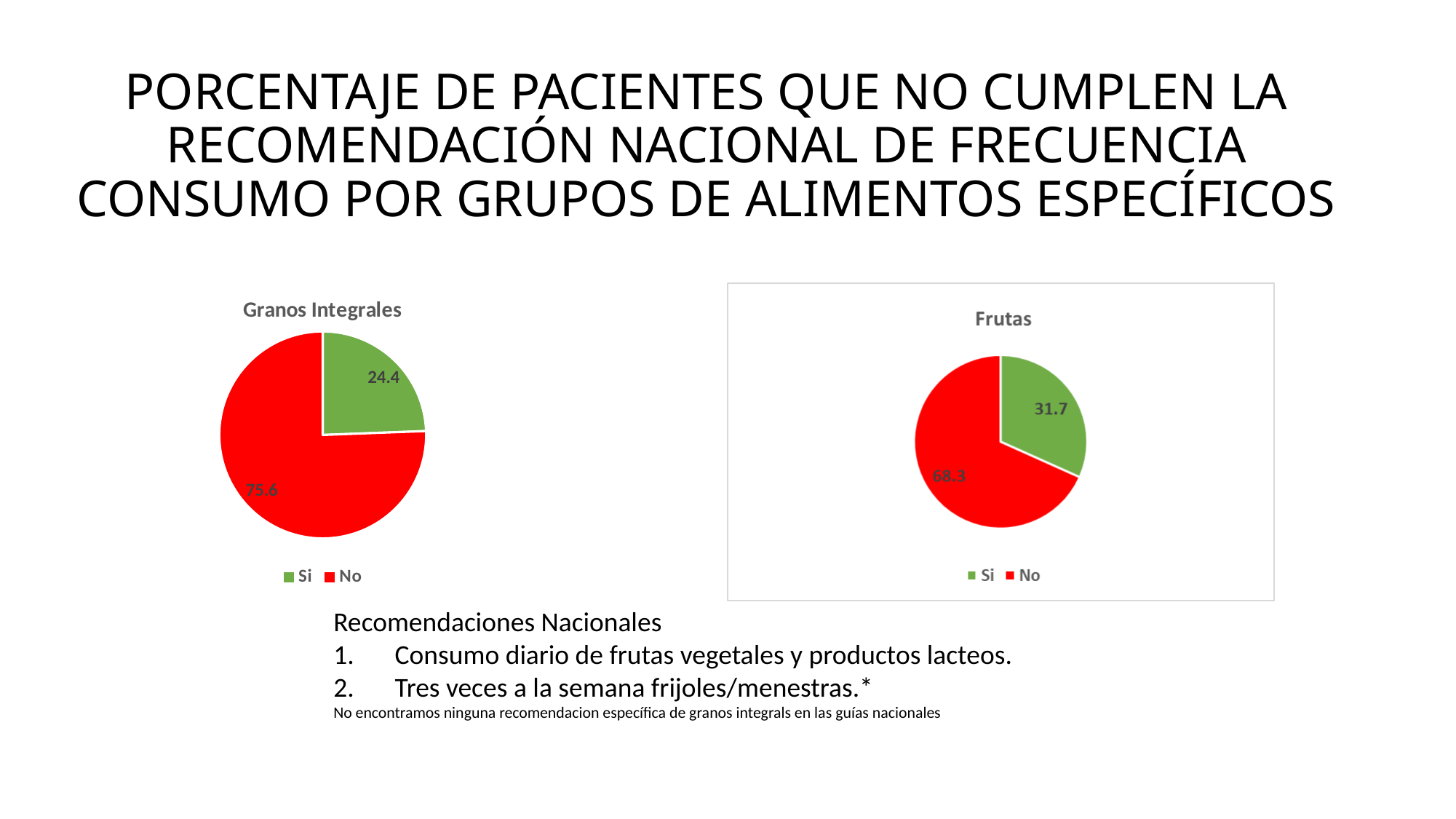
In the "Frutas" pie chart, what is the difference between the "No" and "Si" values? 36.6 In the "Granos Integrales" pie chart, what is the difference between the "No" and "Si" values? 51.2 In the "Frutas" pie chart, what is the value for "Si"? 31.7 How many slices does the "Granos Integrales" pie chart have? 2 In the "Granos Integrales" pie chart, what is the value for "Si"? 24.4 Is the "Si" value larger in the "Granos Integrales" chart or the "Frutas" chart? Frutas In the "Granos Integrales" pie chart, which slice is the largest? No In the "Frutas" pie chart, what colour is the "No" slice? Red In the "Frutas" pie chart, which slice is the smallest? Si In the "Granos Integrales" pie chart, what is the value for "No"? 75.6 In the "Frutas" pie chart, what is the value for "No"? 68.3 What type of chart is the "Frutas" chart? Pie chart